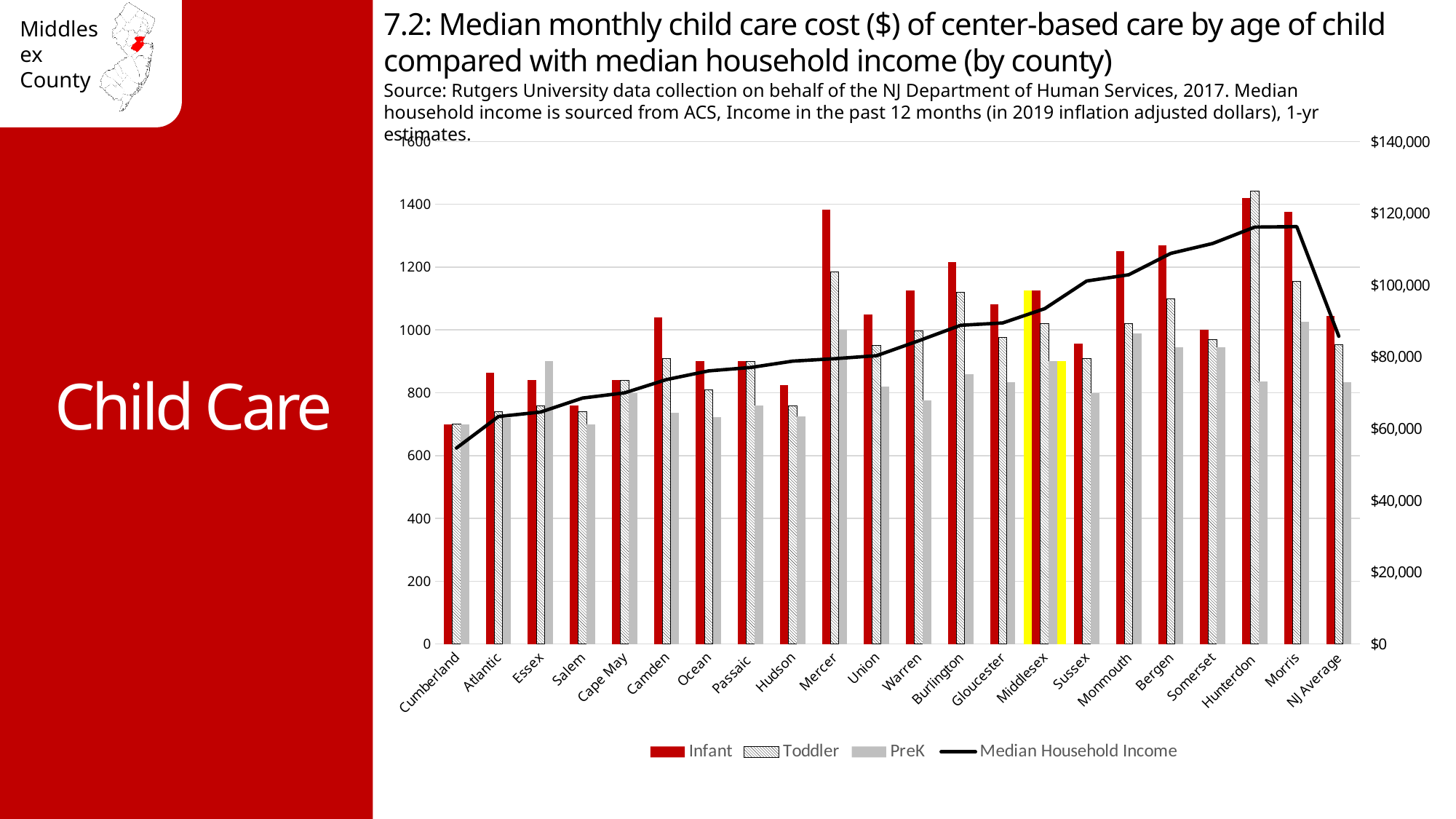
Which county's bars are highlighted in yellow on the chart? Middlesex Which county has the lowest Infant child care cost? Cumberland Which county has the highest Toddler child care cost? Hunterdon What kind of chart is used to show the child care costs by age of child? Bar chart (with a line for median household income) Which county has the highest Infant child care cost? Hunterdon Which is larger, the Infant cost for Mercer or the Infant cost for Union? Mercer How many counties/categories are shown on the x axis of the chart? 22 How many series does the chart legend list? 4 Does the Median Household Income line generally rise or fall from Cumberland to Morris? rise Is the Infant child care cost for Cumberland greater or less than 800? less Is the Infant child care cost for Mercer greater or less than 1200? greater Is the median household income for Morris greater or less than $100,000? greater